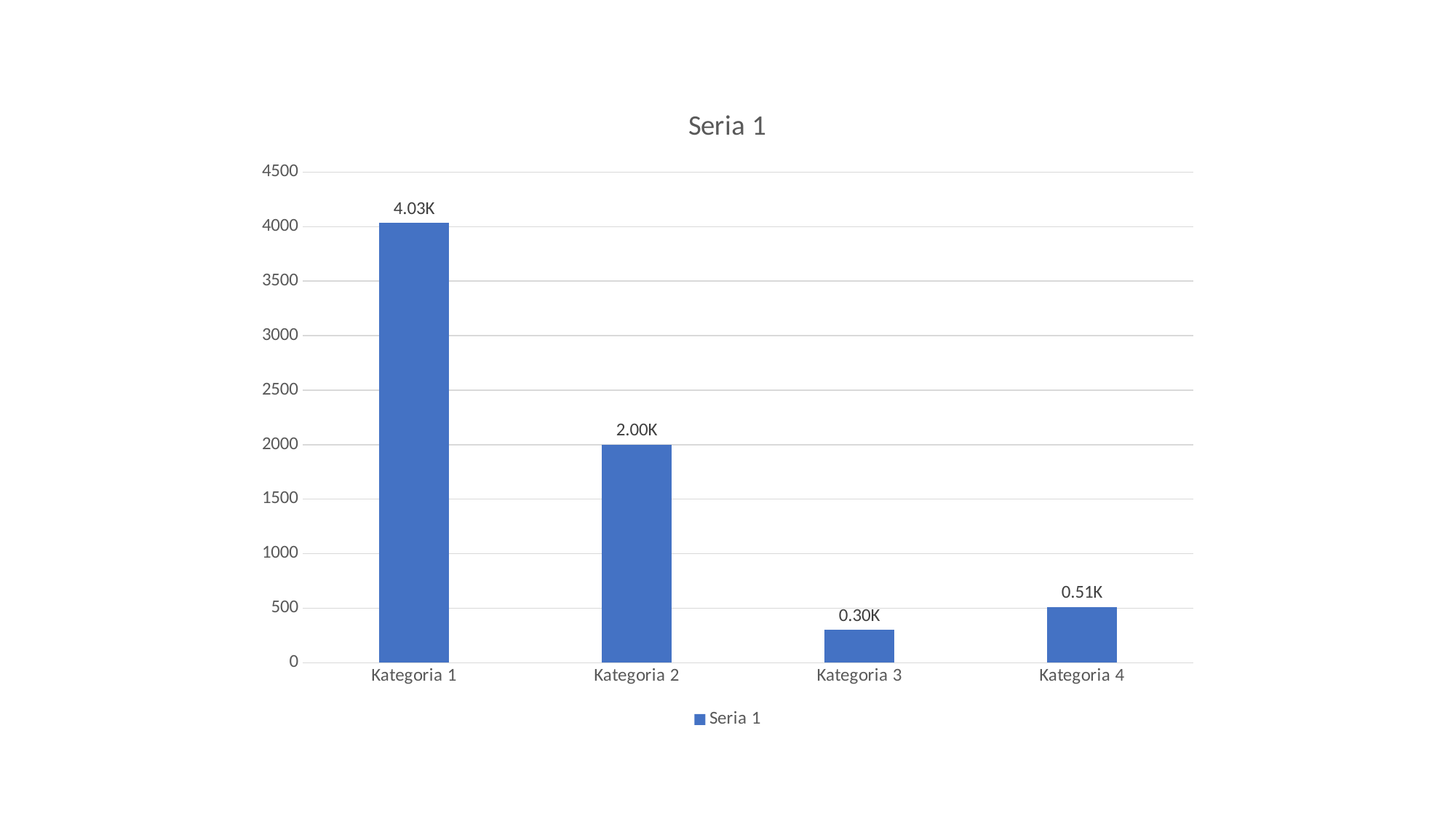
What is the value for Kategoria 1? 4.03K How many categories are shown on the x axis? 4 Is the value for Kategoria 1 greater or less than 3500? greater What is the value for Kategoria 2? 2.00K Is the value for Kategoria 3 greater or less than 500? less What is the value for Kategoria 3? 0.30K Which category has the highest value? Kategoria 1 How many series does the legend list? 1 What is the value for Kategoria 4? 0.51K Which category has the lowest value? Kategoria 3 What kind of chart is shown on the slide? Bar chart Which is larger, the value for Kategoria 2 or the value for Kategoria 4? Kategoria 2